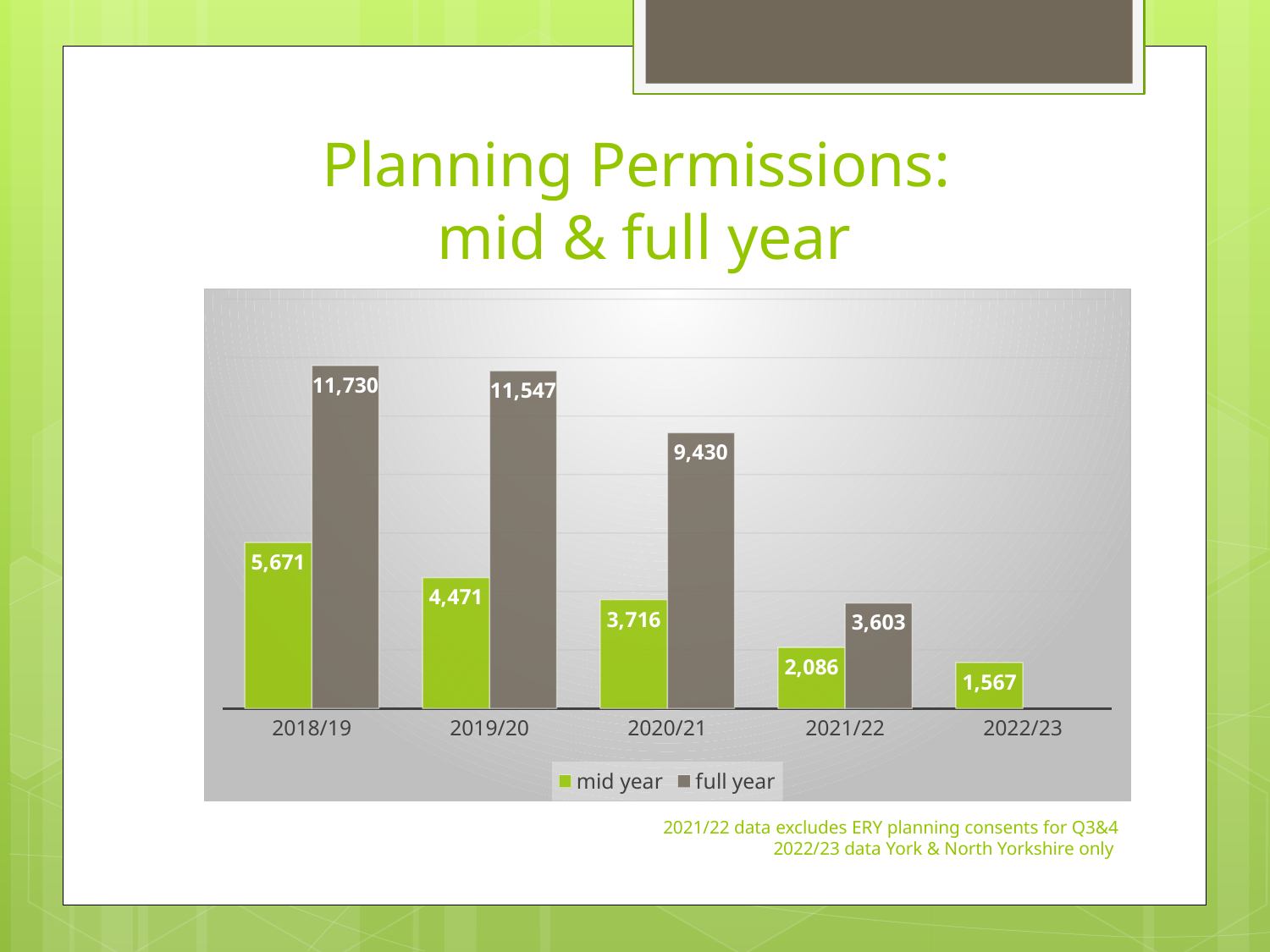
How many years are shown on the x axis? 5 What is the difference between the full year and mid year values for 2019/20? 7,076 What is the mid year value for 2022/23? 1,567 What is the mid year value for 2018/19? 5,671 What kind of chart is shown on the slide? bar chart Which year has the lowest mid year value? 2022/23 What is the full year value for 2020/21? 9,430 Which year has the highest full year value? 2018/19 Do the mid year values rise or fall from 2018/19 to 2022/23? fall What is the full year value for 2021/22? 3,603 How many series does the legend list? 2 Which is larger: the mid year value for 2020/21 or the full year value for 2021/22? mid year value for 2020/21